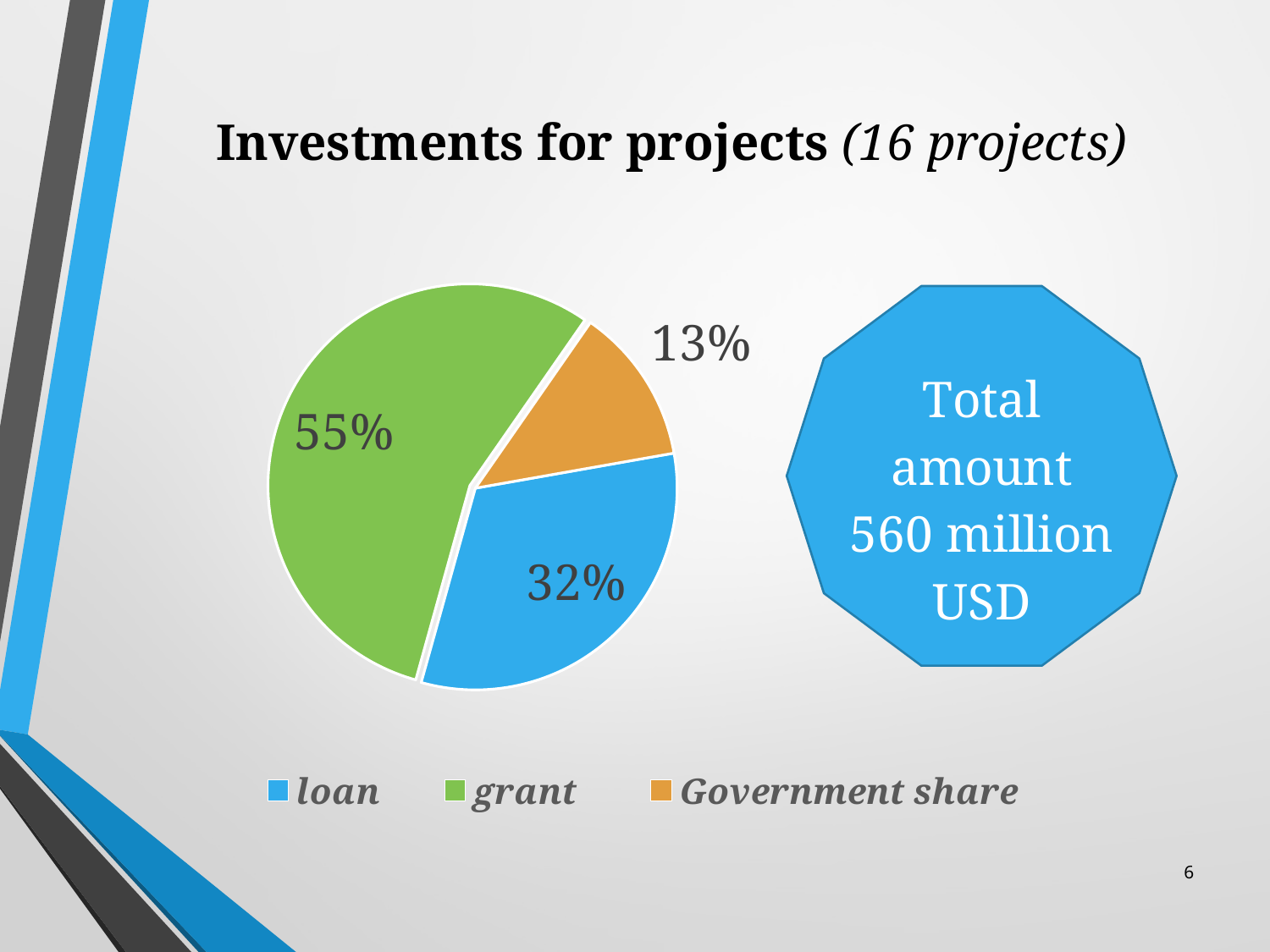
Which category has the largest slice of the pie? grant Which category has the smallest slice of the pie? Government share What is the difference in percentage points between the grant slice and the loan slice? 23 How many entries does the legend list? 3 What share of the pie does the Government share slice represent? 13% What colour is the grant slice in the pie chart? green Which is larger, the loan slice or the Government share slice? loan What kind of chart is shown on the slide? pie chart What is the difference in percentage points between the loan slice and the Government share slice? 19 How many slices does the pie chart have? 3 What share of the pie does the grant slice represent? 55% What share of the pie does the loan slice represent? 32%